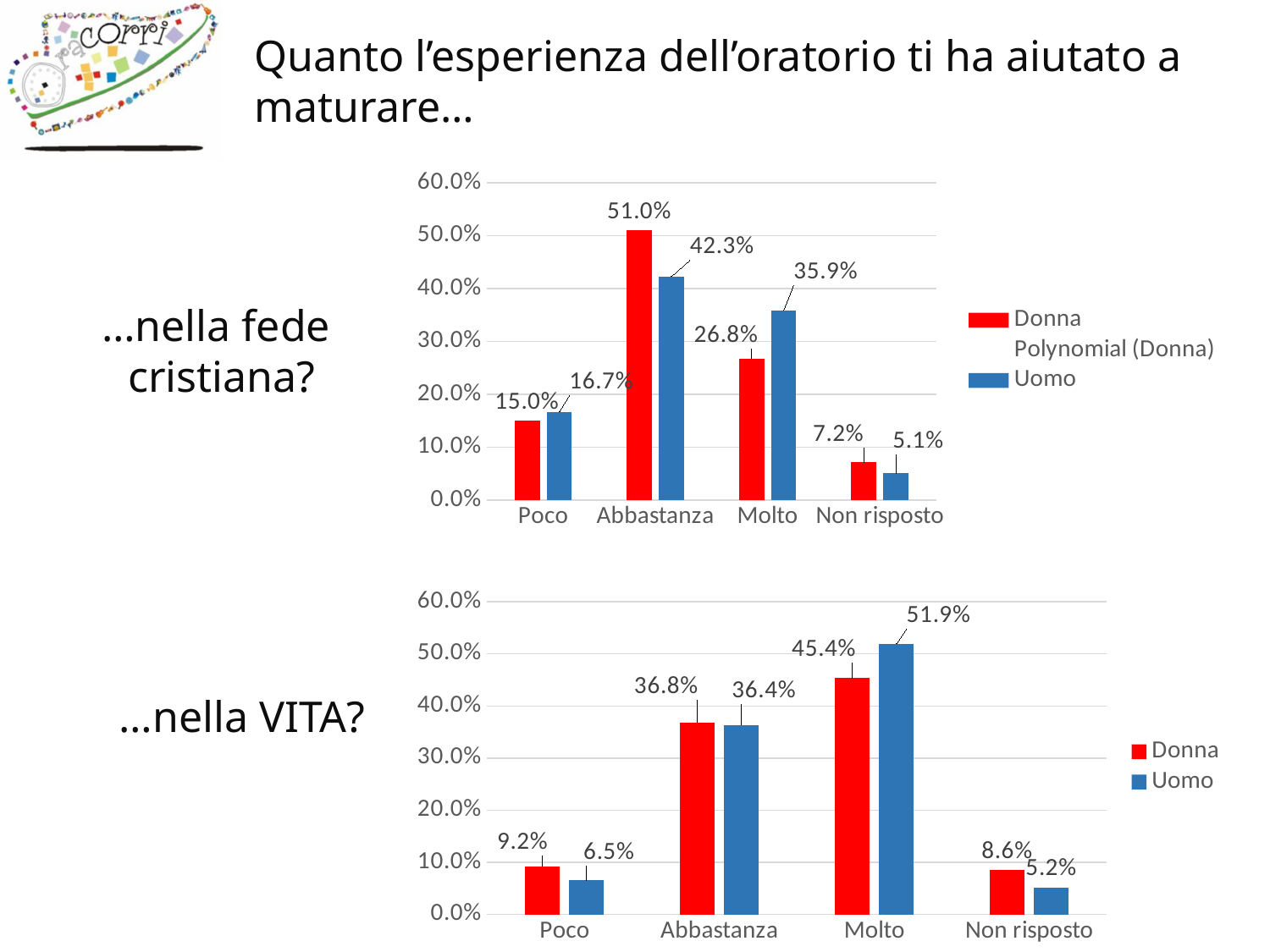
In the top chart ("...nella fede cristiana?"), what is the value for Donna in the Abbastanza category? 51.0% In the top chart ("...nella fede cristiana?"), which is larger for Molto: Donna or Uomo? Uomo In the bottom chart ("...nella VITA?"), how many categories are shown on the x axis? 4 In the top chart ("...nella fede cristiana?"), what is the difference between the Donna and Uomo values for Abbastanza? 8.7% In the top chart ("...nella fede cristiana?"), how many entries does the legend list? 3 In the top chart ("...nella fede cristiana?"), which category has the lowest value for Uomo? Non risposto In the top chart ("...nella fede cristiana?"), what is the value for Uomo in the Molto category? 35.9% In the bottom chart ("...nella VITA?"), what is the value for Donna in the Poco category? 9.2% In the bottom chart ("...nella VITA?"), which category has the highest value for Donna? Molto In the bottom chart ("...nella VITA?"), what is the difference between the Uomo and Donna values for Molto? 6.5% In the bottom chart ("...nella VITA?"), what is the value for Uomo in the Molto category? 51.9% What type of chart is the bottom chart ("...nella VITA?")? Bar chart